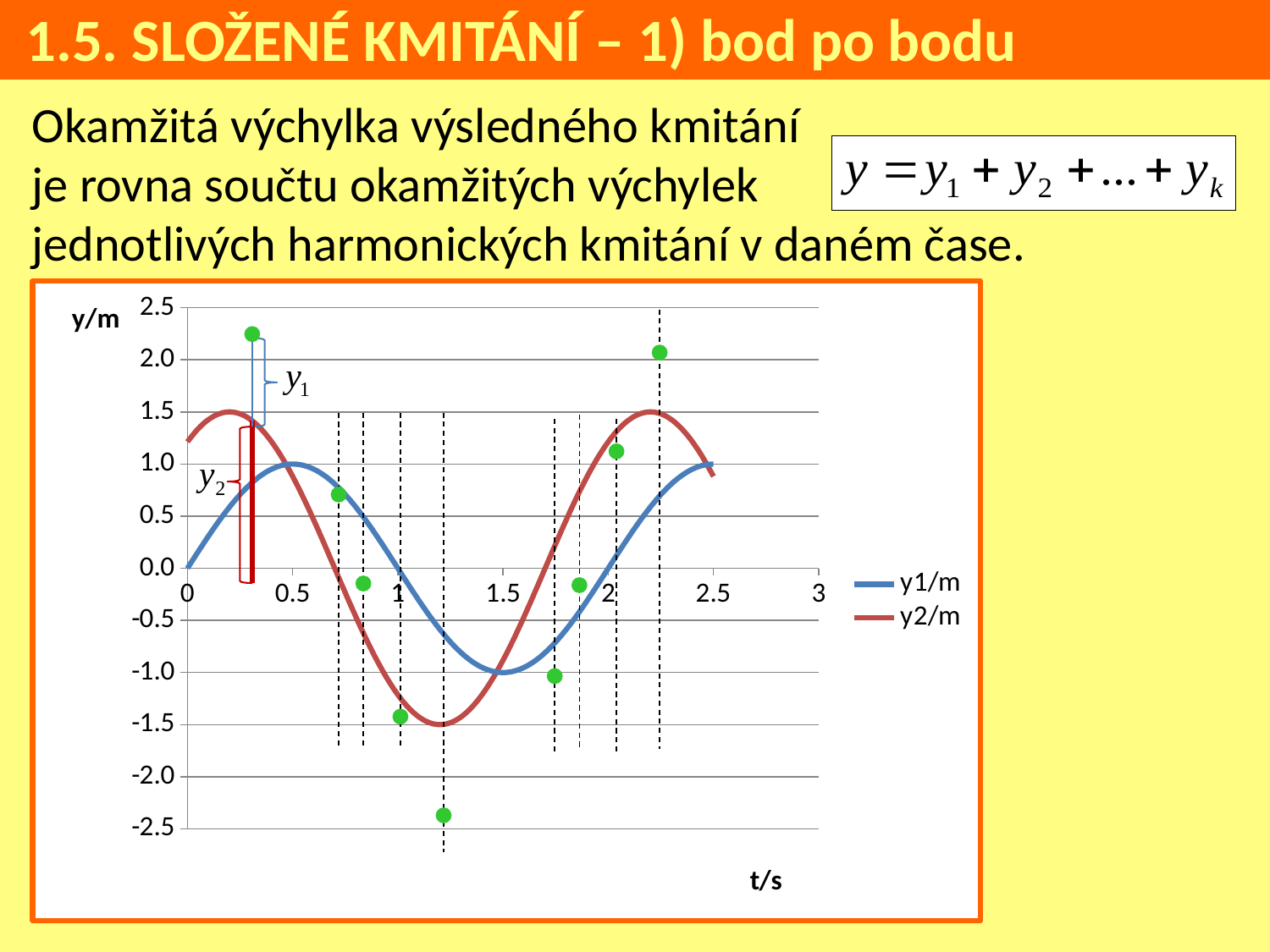
Which series has the larger peak value, y1/m or y2/m? y2/m What is the minimum value reached by the y2/m curve? -1.5 Is the highest green dot (near t = 0.3) greater or less than 2.0? greater Is the lowest green dot (near t = 1.2) greater or less than -2.0? less What is the maximum value reached by the y2/m curve? 1.5 What kind of chart is shown on the slide? line chart What is the label of the horizontal axis? t/s How many series does the legend list? 2 At t = 1, which series has the lower value, y1/m or y2/m? y2/m What are the two series names in the legend? y1/m and y2/m What is the value of y1/m at t = 0? 0.0 What is the maximum value reached by the y1/m curve? 1.0